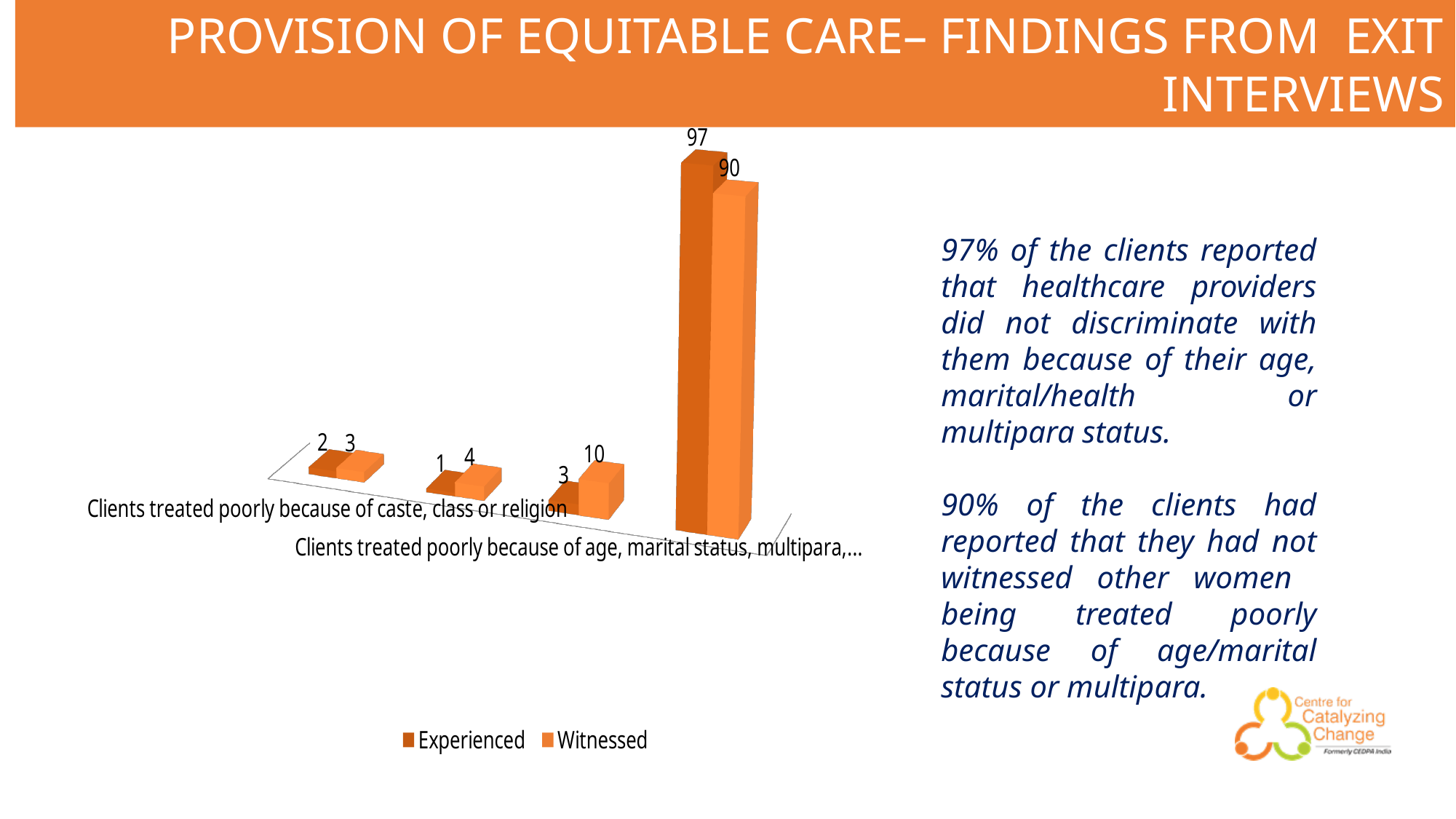
What kind of chart is shown on the slide? Bar chart What are the two series named in the chart legend? Experienced and Witnessed In the tallest group of bars, what is the difference between the Experienced value (97) and the Witnessed value (90)? 7 What is the highest Witnessed value shown in the chart? 90 What is the Witnessed value for 'Clients treated poorly because of caste, class or religion'? 3 What is the Experienced value for 'Clients treated poorly because of caste, class or religion'? 2 What is the lowest Experienced value shown in the chart? 1 In the tallest group of bars, which series has the larger value, Experienced or Witnessed? Experienced How many series does the chart legend list? 2 What is the highest Experienced value shown in the chart? 97 For 'Clients treated poorly because of caste, class or religion', which series has the larger value, Experienced or Witnessed? Witnessed How many groups of bars are plotted in the chart? 4